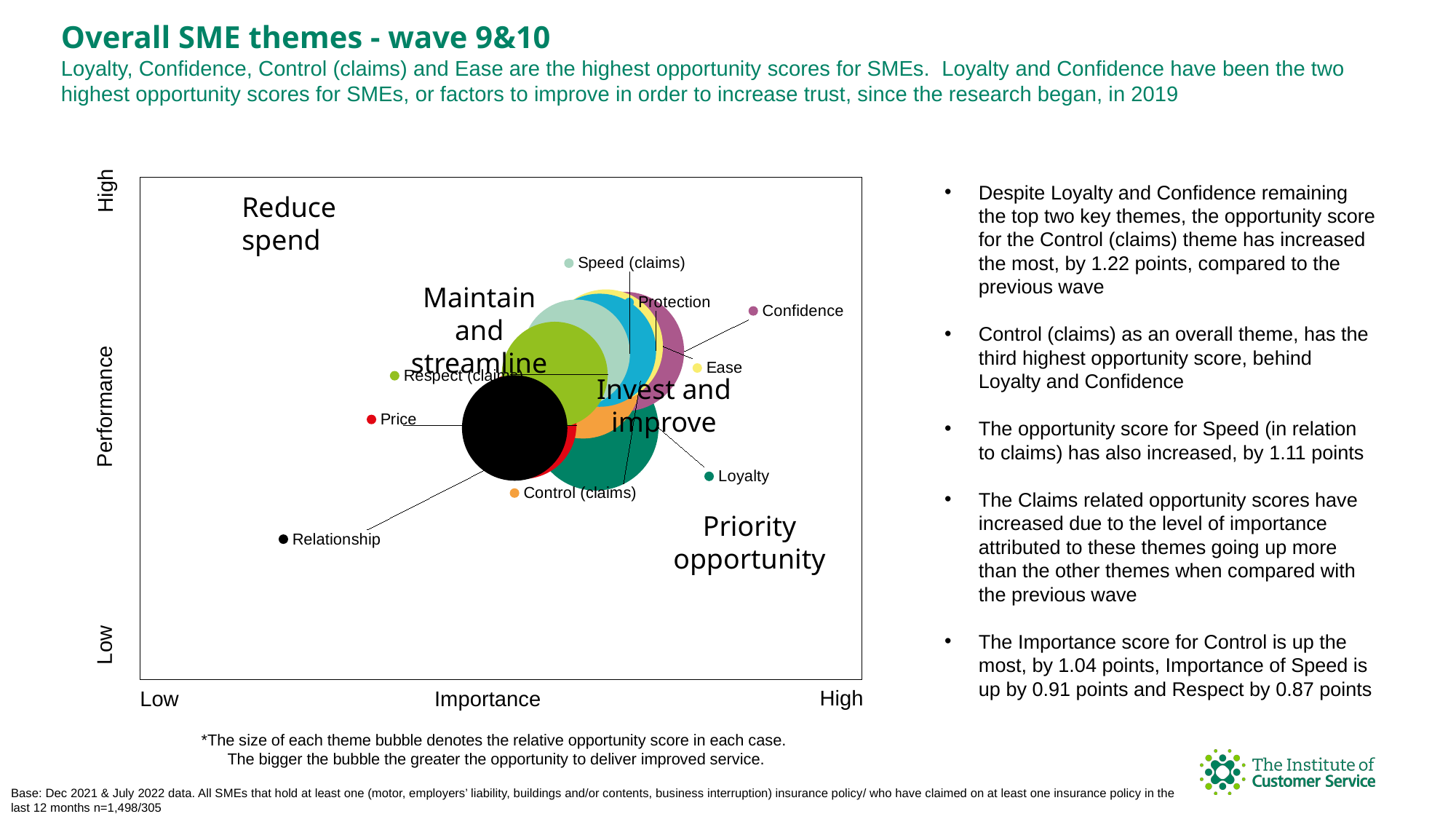
How many theme bubbles are labelled on the chart? 9 Which theme is plotted higher on the Performance axis, Speed (claims) or Control (claims)? Speed (claims) What kind of chart is shown on the slide? Bubble chart What is the label of the horizontal axis of the chart? Importance What is the label of the vertical axis of the chart? Performance